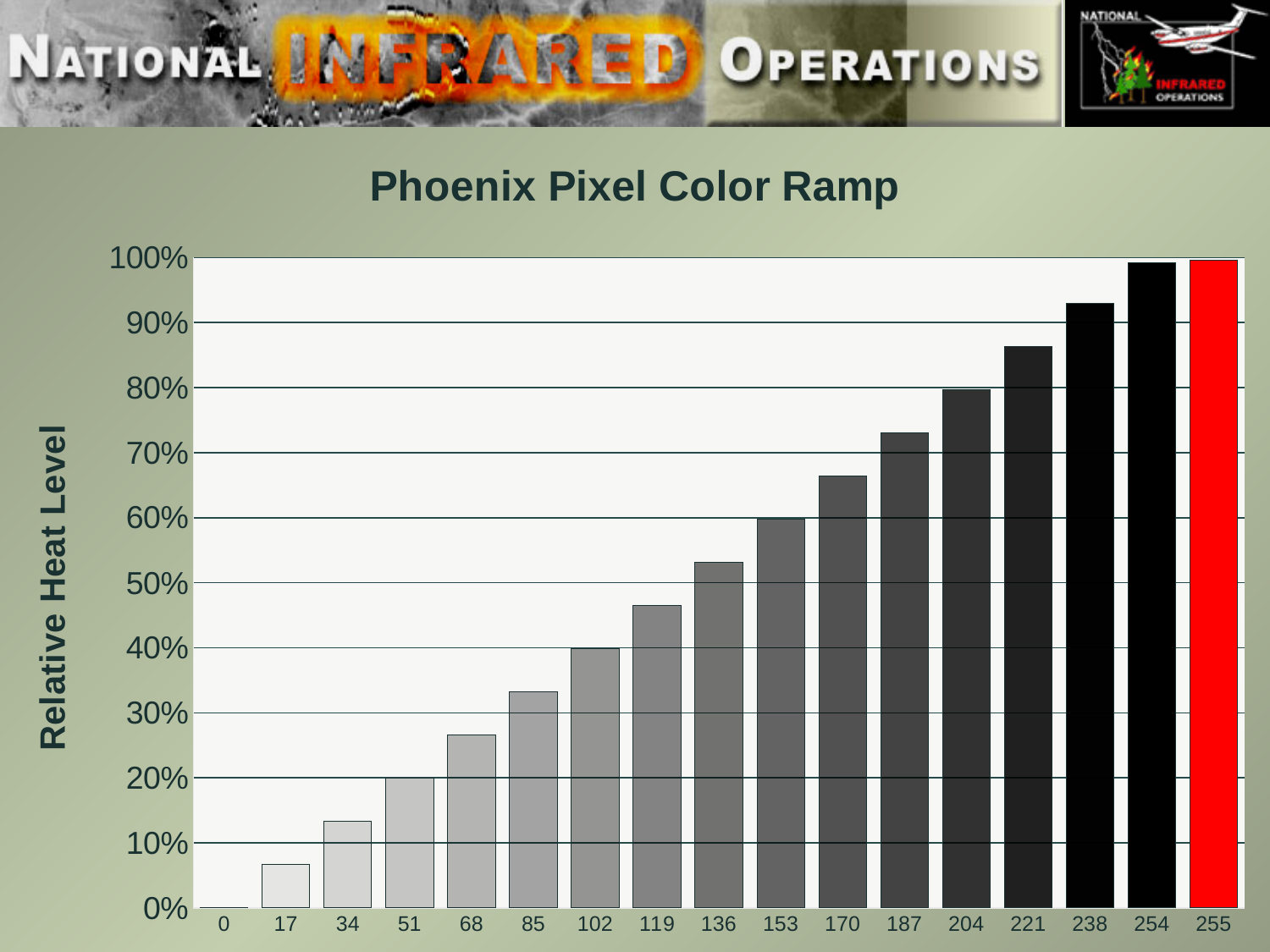
Is the value for pixel 221 greater or less than 80%? greater Is the value for pixel 170 greater or less than 60%? greater Is the value for pixel 68 greater or less than 30%? less Which has a higher relative heat level, pixel 136 or pixel 85? 136 Which category has the lowest relative heat level? 0 What is the title of the chart? Phoenix Pixel Color Ramp Do the values rise or fall as the pixel value increases along the x axis? rise How many categories are shown along the x axis? 17 What kind of chart is shown on the slide? bar chart What is the label of the y axis? Relative Heat Level